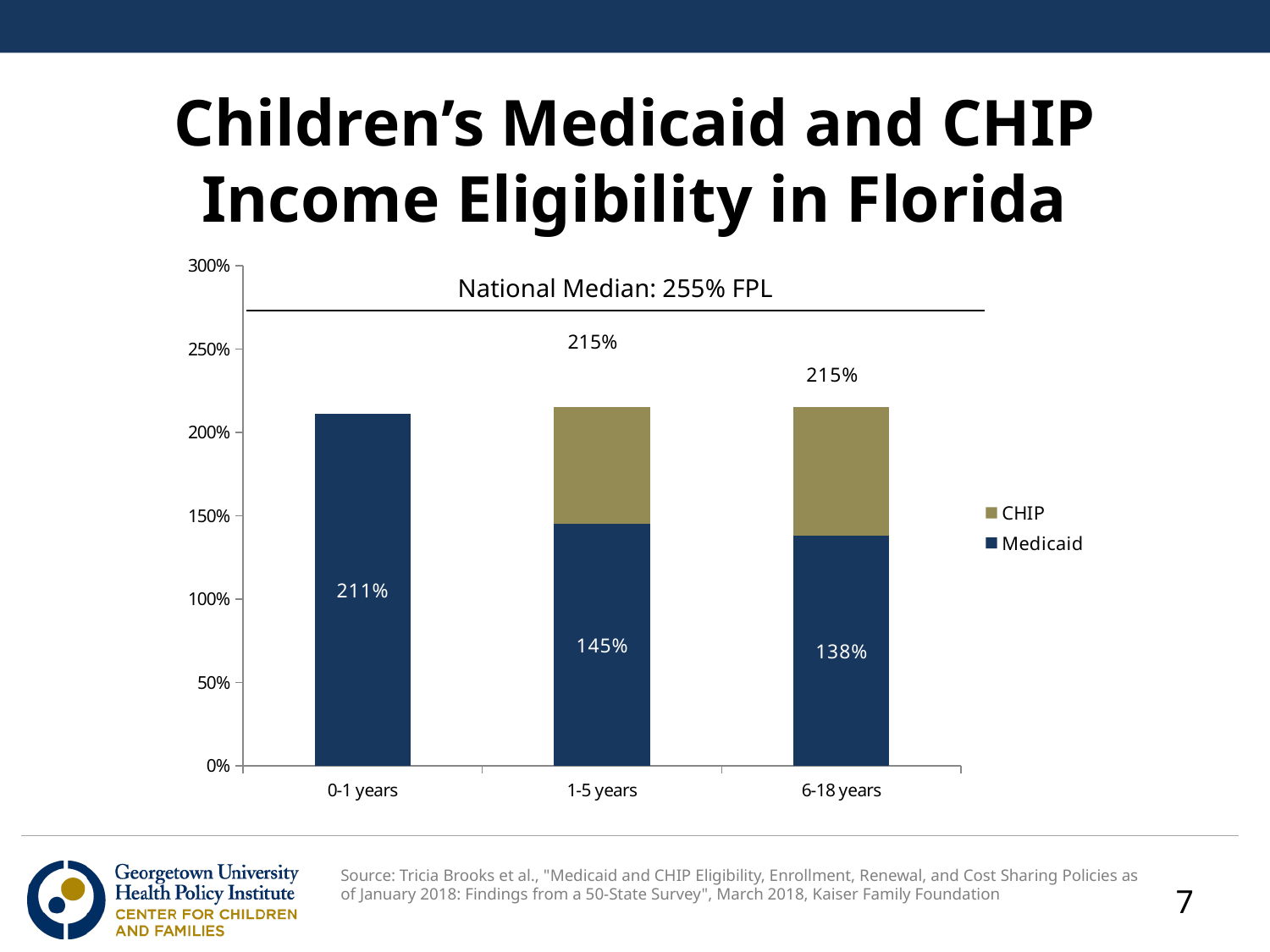
What is the Medicaid income eligibility value for the 1-5 years age group? 145% Which age group has the highest Medicaid eligibility value? 0-1 years Based on the printed labels, what is the CHIP portion of the 6-18 years bar (total minus Medicaid)? 77% Is the Medicaid value for the 1-5 years age group larger or smaller than the Medicaid value for the 0-1 years age group? smaller What is the Medicaid income eligibility value for the 0-1 years age group? 211% What is the difference between the Medicaid values for the 1-5 years and 6-18 years age groups? 7% How many age groups are shown on the x axis? 3 Which age group has the lowest Medicaid eligibility value? 6-18 years How many series does the legend list? 2 What national median value is indicated by the horizontal line on the chart? 255% FPL What is the Medicaid income eligibility value for the 6-18 years age group? 138% What is the total income eligibility (Medicaid plus CHIP) shown above the bar for the 1-5 years age group? 215%